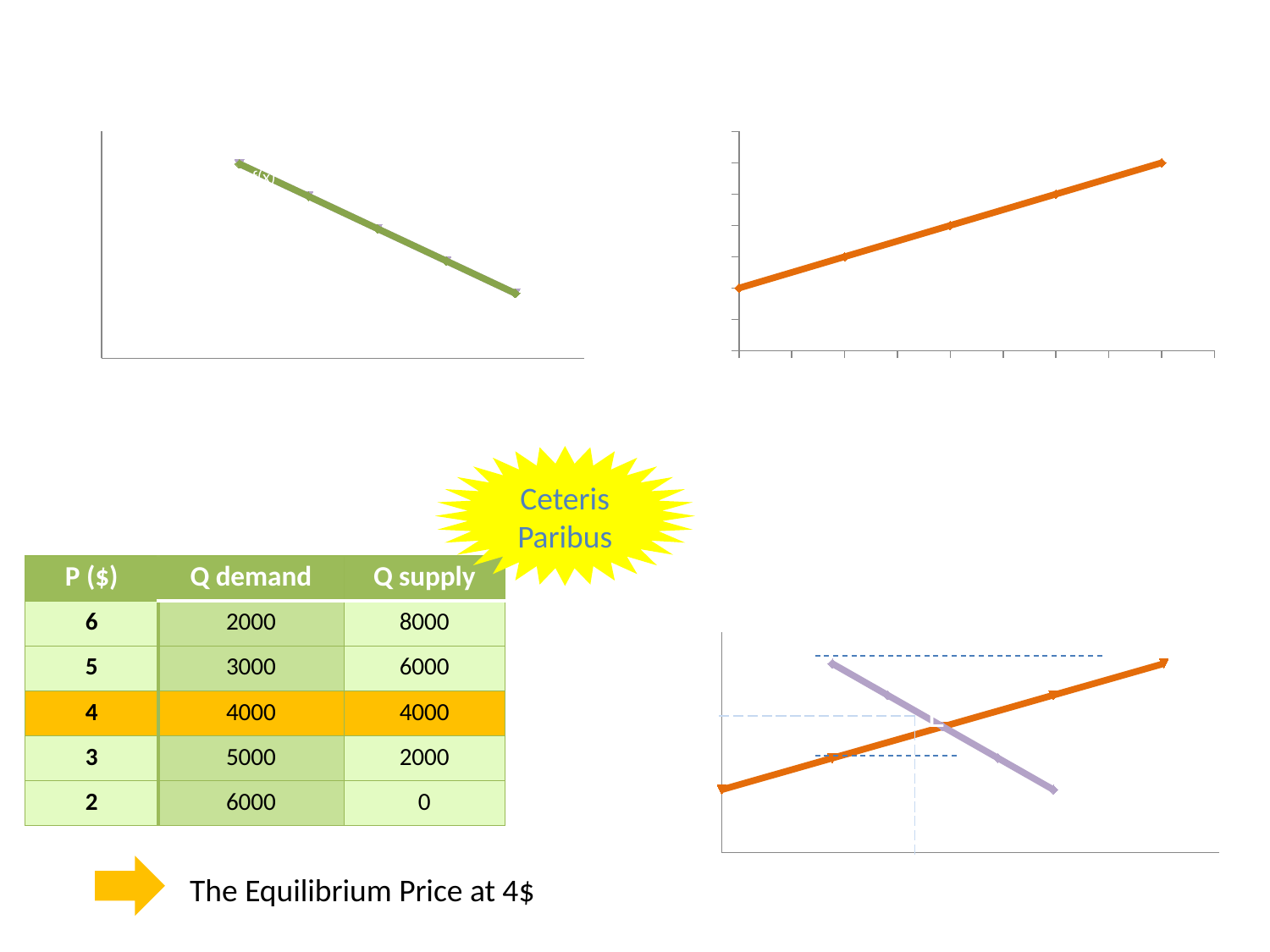
What colour is the line in the top-right chart? orange What colour is the line in the top-left chart? green What kind of chart is the bottom-right chart on the slide? line chart In the top-left chart, do the values rise or fall along the x axis? fall How many lines are plotted in the bottom-right chart? 2 In the top-right chart, do the values rise or fall along the x axis? rise In the bottom-right chart, does the purple line rise or fall along the x axis? fall What kind of chart is the top-right chart on the slide? line chart How many lines are plotted in the top-left chart? 1 What kind of chart is the top-left chart on the slide? line chart